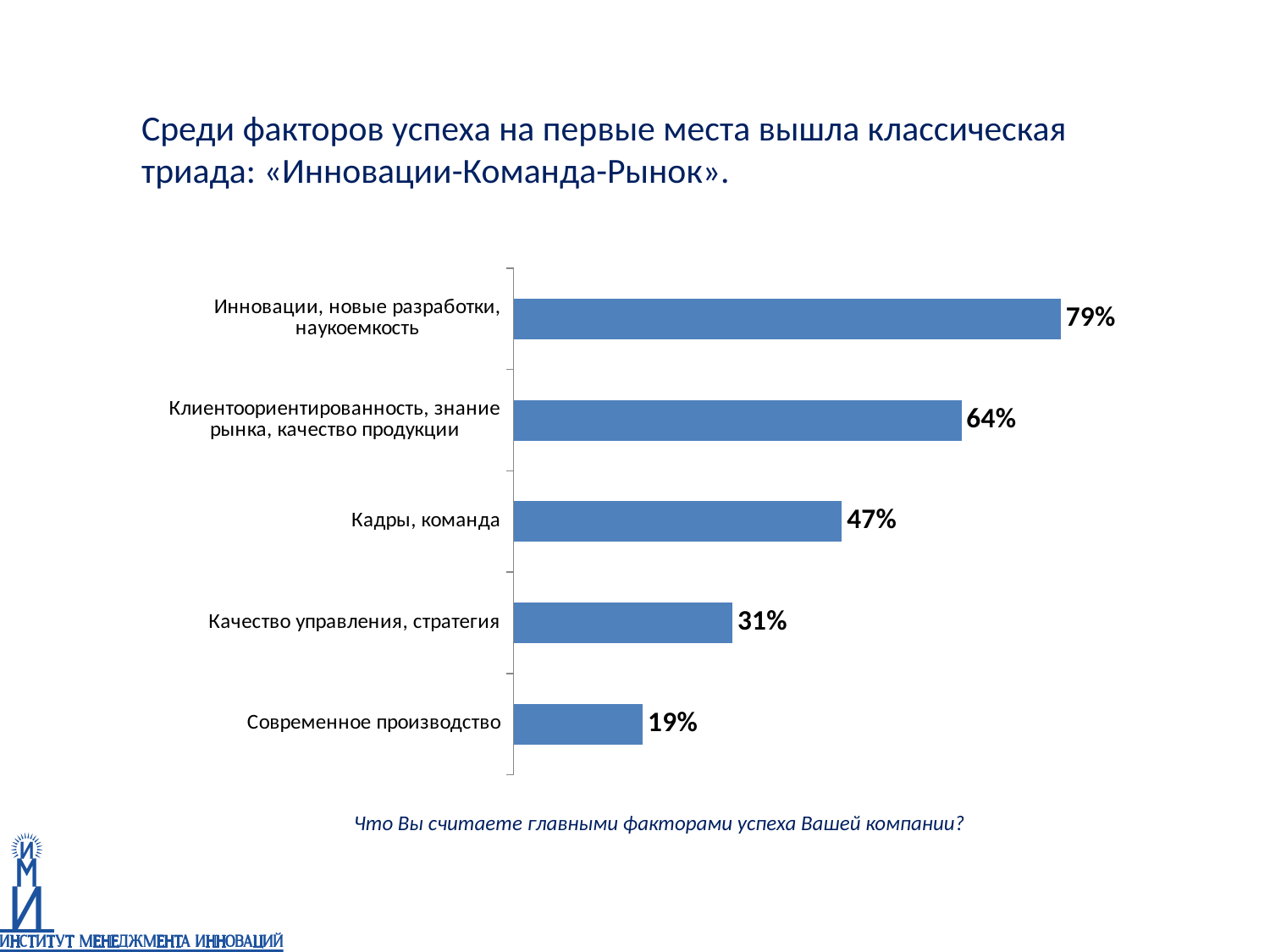
What is the difference between the values for «Инновации, новые разработки, наукоемкость» and «Клиентоориентированность, знание рынка, качество продукции»? 15% How many factors (categories) are shown in the chart? 5 Which factor has the highest value? Инновации, новые разработки, наукоемкость What value is shown for «Инновации, новые разработки, наукоемкость»? 79% Which is larger: the value for «Клиентоориентированность, знание рынка, качество продукции» or for «Кадры, команда»? Клиентоориентированность, знание рынка, качество продукции Which factor has the lowest value? Современное производство What value is shown for «Качество управления, стратегия»? 31% What value is shown for «Современное производство»? 19% What is the difference between the values for «Кадры, команда» and «Современное производство»? 28% What survey question is written below the chart? Что Вы считаете главными факторами успеха Вашей компании? What kind of chart is shown on the slide? Bar chart What value is shown for «Кадры, команда»? 47%